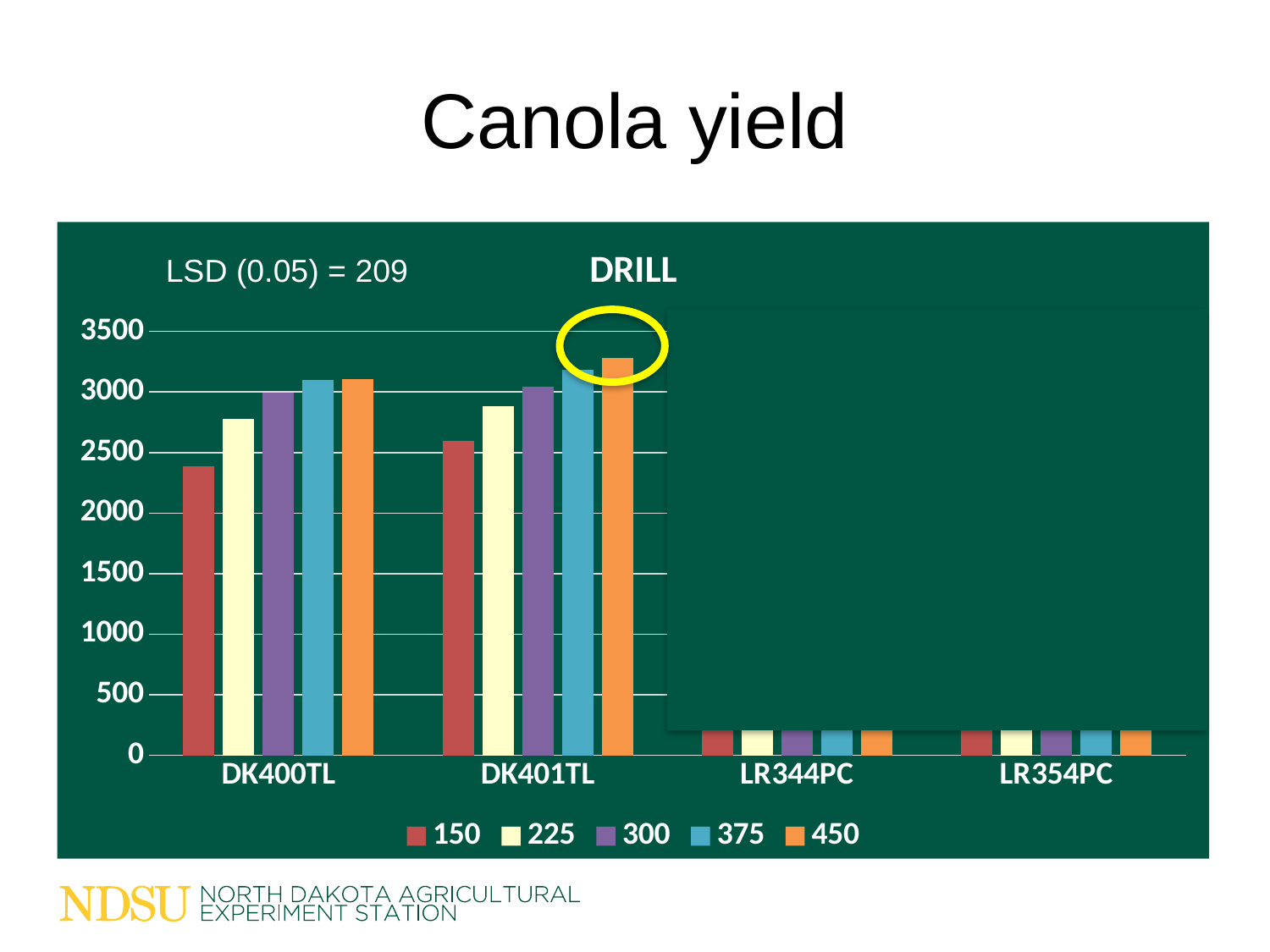
Which is larger: the 150 series value at DK400TL or the 150 series value at DK401TL? DK401TL What kind of chart is shown on the slide? bar chart Is the value for the 150 series at DK400TL greater or less than 2500? less How many series does the legend list? 5 What LSD value is printed on the chart? LSD (0.05) = 209 Is the value for the 225 series at DK400TL greater or less than 2500? greater Which series has the lowest value at DK400TL? 150 Is the value for the 150 series at DK401TL greater or less than 3000? less What is the title of the chart? DRILL How many categories are shown on the x axis? 4 Within the DK401TL group, do the values rise or fall going from the 150 series to the 450 series? rise